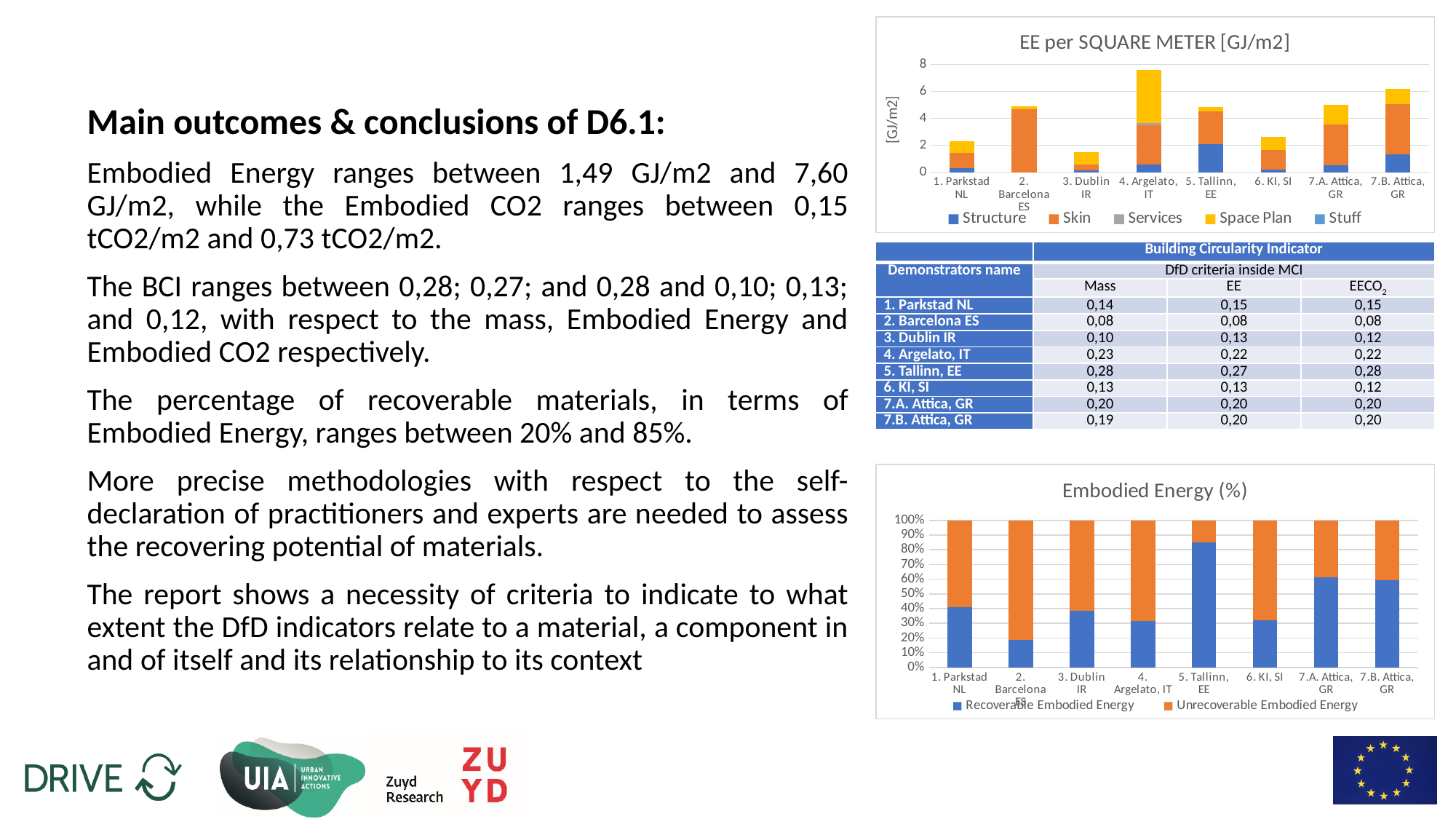
On the 'Embodied Energy (%)' chart, which demonstrator has the highest share of Recoverable Embodied Energy? 5. Tallinn, EE How many series does the legend of the 'Embodied Energy (%)' chart list? 2 How many demonstrators (categories) are shown on the 'EE per SQUARE METER [GJ/m2]' chart? 8 On the 'EE per SQUARE METER [GJ/m2]' chart, which demonstrator has the highest total embodied energy per square meter? 4. Argelato, IT What kind of chart is the 'EE per SQUARE METER [GJ/m2]' chart? stacked bar chart How many series does the legend of the 'EE per SQUARE METER [GJ/m2]' chart list? 5 On the 'EE per SQUARE METER [GJ/m2]' chart, is the total value for 2. Barcelona ES greater or less than 4? greater On the 'EE per SQUARE METER [GJ/m2]' chart, which series is shown in yellow? Space Plan On the 'Embodied Energy (%)' chart, is the Recoverable Embodied Energy share for 5. Tallinn, EE greater or less than 80%? greater On the 'EE per SQUARE METER [GJ/m2]' chart, which demonstrator has the lowest total embodied energy per square meter? 3. Dublin IR On the 'Embodied Energy (%)' chart, which demonstrator has the lowest share of Recoverable Embodied Energy? 2. Barcelona ES On the 'EE per SQUARE METER [GJ/m2]' chart, is the total value for 3. Dublin IR greater or less than 2? less